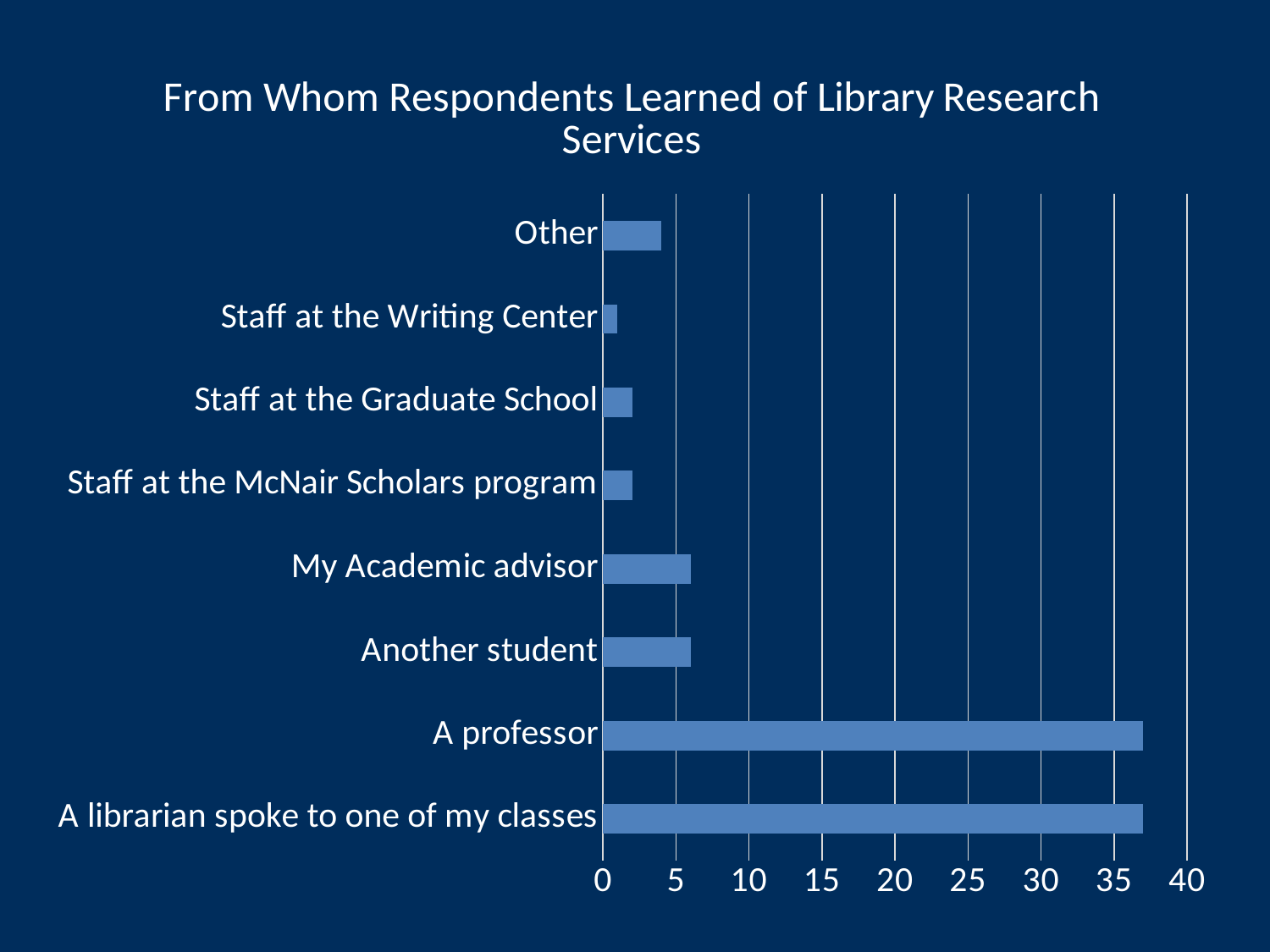
Which is larger, the value for "A professor" or the value for "My Academic advisor"? A professor Is the value for "A professor" greater or less than 35? greater What is the title of the chart? From Whom Respondents Learned of Library Research Services Is the value for "A librarian spoke to one of my classes" greater or less than 30? greater Is the value for "My Academic advisor" greater or less than 5? greater What kind of chart is shown on the slide? bar chart Which category has the lowest value? Staff at the Writing Center Which is larger, the value for "Another student" or the value for "Staff at the McNair Scholars program"? Another student Which is larger, the value for "Other" or the value for "Staff at the Writing Center"? Other How many categories are plotted in the chart? 8